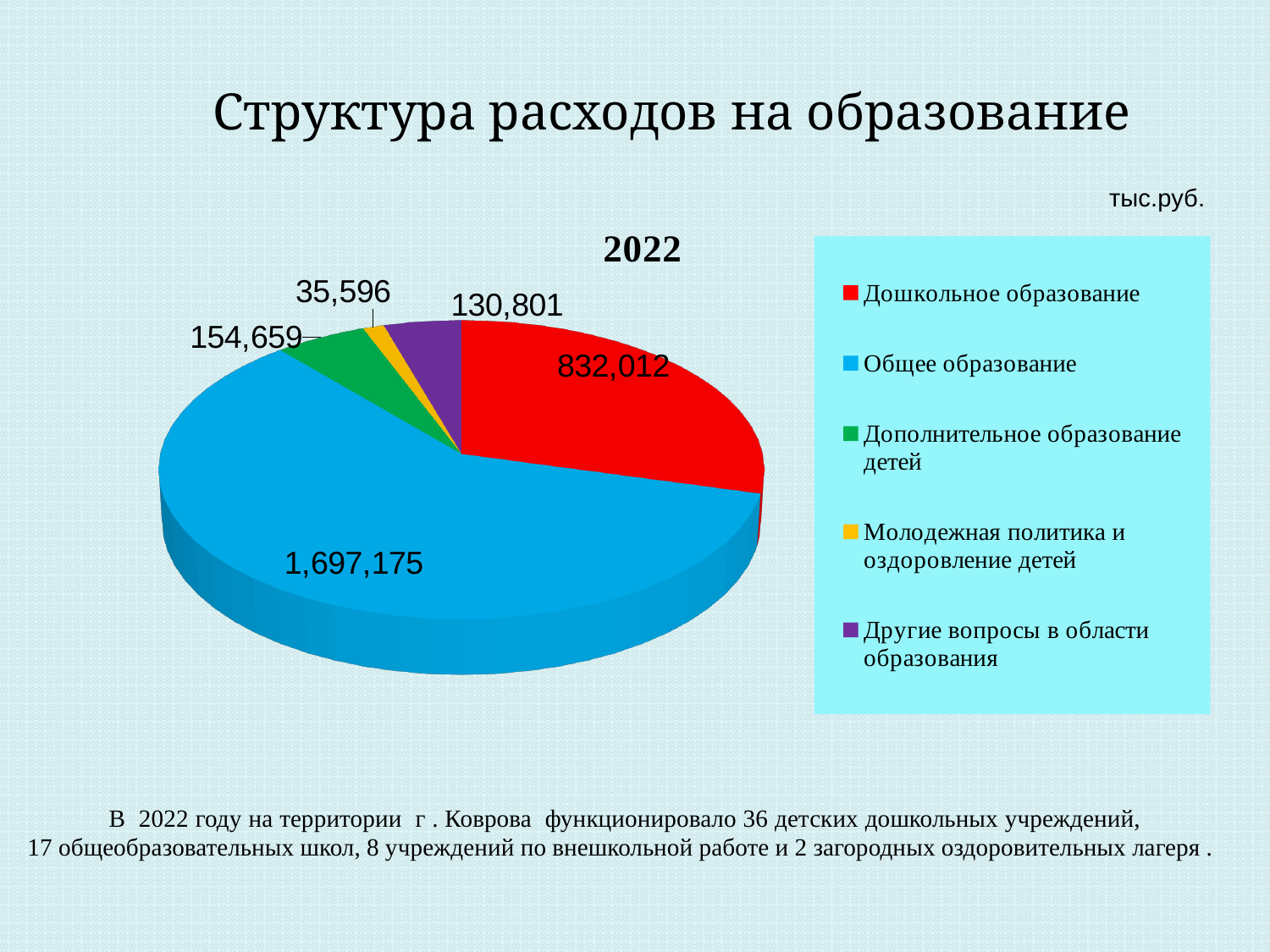
What is the value for Дошкольное образование? 832,012 Which category has the smallest share of the pie? Молодежная политика и оздоровление детей What is the value for Общее образование? 1,697,175 In what units are the values on the chart given? тыс.руб. What is the difference between the values for Общее образование and Дошкольное образование? 865,163 What kind of chart is shown on the slide? Pie chart Which is larger: Дополнительное образование детей or Другие вопросы в области образования? Дополнительное образование детей What is the value for Молодежная политика и оздоровление детей? 35,596 What is the value for Другие вопросы в области образования? 130,801 How many slices does the pie chart have? 5 Which category has the largest share of the pie? Общее образование What is the total of all slices in the pie chart? 2,850,243